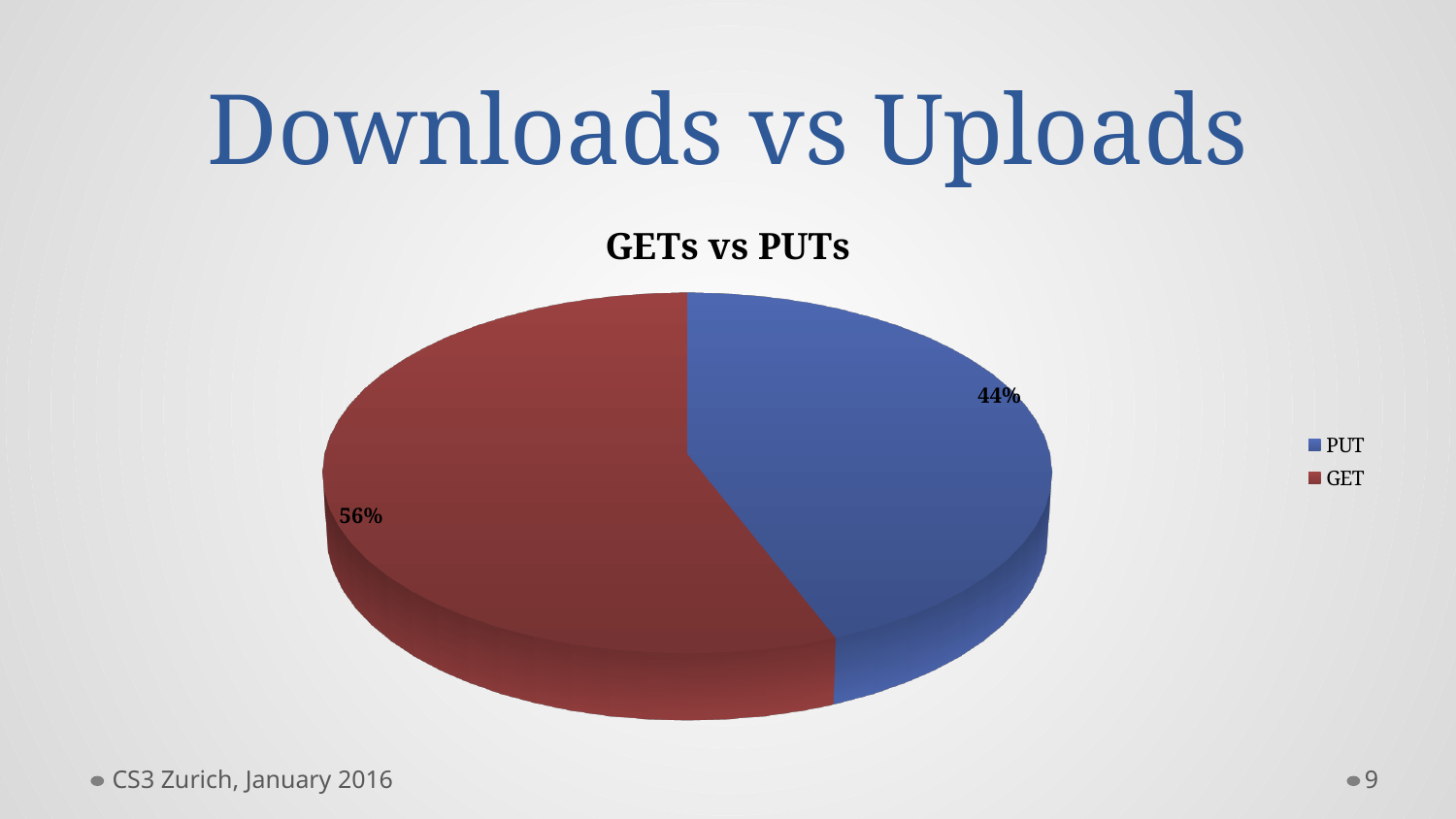
Which category has the smallest slice of the pie? PUT What is the difference in percentage points between the GET and PUT slices? 12 What is the title of the chart? GETs vs PUTs What share of the pie does PUT represent? 44% How many slices does the pie chart have? 2 What share of the pie does GET represent? 56% What kind of chart is shown on the slide? Pie chart What colour is the GET slice? Red How many entries does the legend list? 2 Which is larger, the GET slice or the PUT slice? GET Which category has the largest slice of the pie? GET